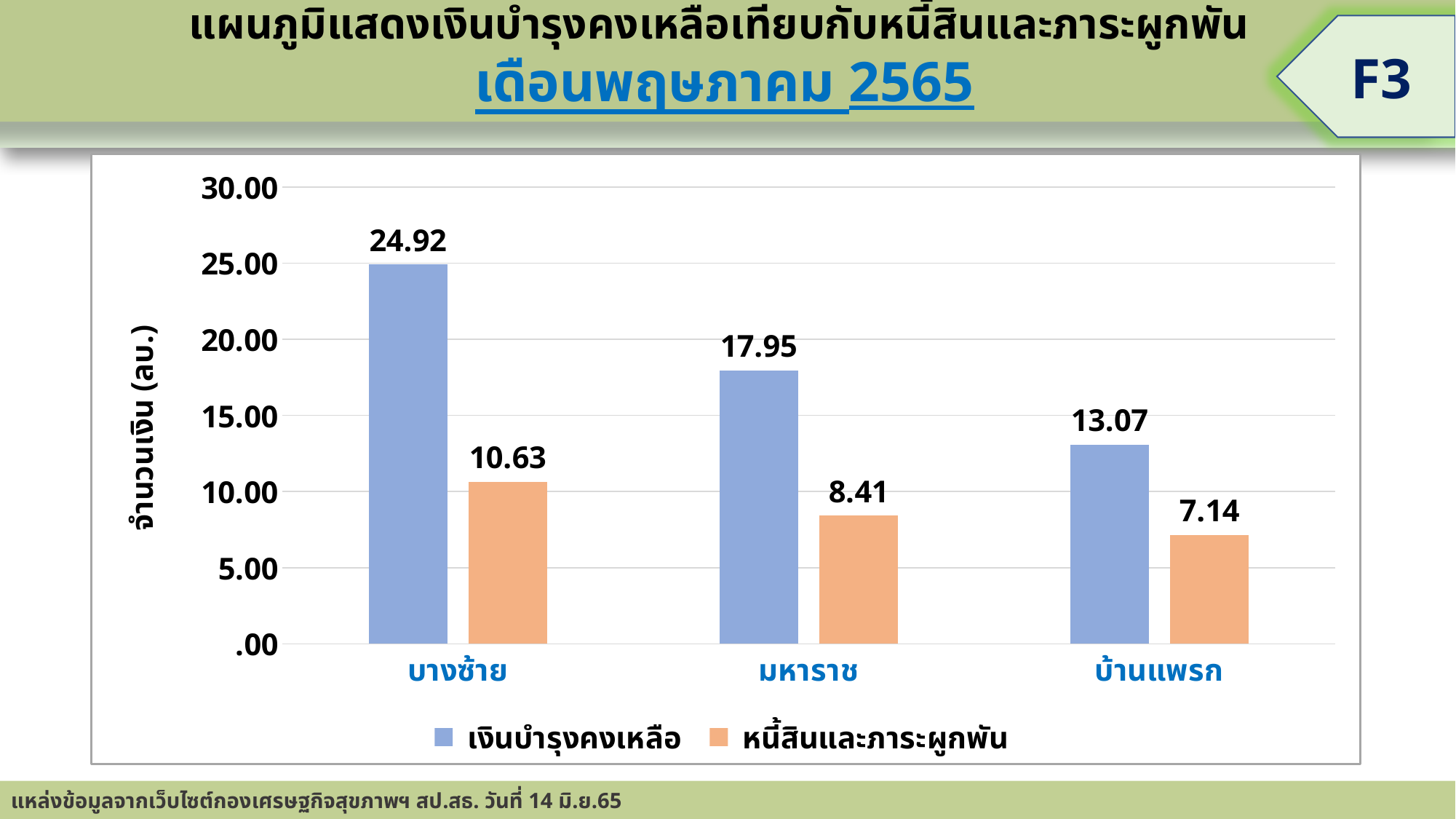
Do the values of เงินบำรุงคงเหลือ rise or fall from บางซ้าย to บ้านแพรก? fall What is the value of เงินบำรุงคงเหลือ for บางซ้าย? 24.92 What is the difference between เงินบำรุงคงเหลือ and หนี้สินและภาระผูกพัน for บางซ้าย? 14.29 Which category has the highest value of เงินบำรุงคงเหลือ? บางซ้าย What is the value of หนี้สินและภาระผูกพัน for มหาราช? 8.41 What is the value of เงินบำรุงคงเหลือ for บ้านแพรก? 13.07 How many series does the legend list? 2 What kind of chart is shown on the slide? bar chart Which category has the lowest value of หนี้สินและภาระผูกพัน? บ้านแพรก Is the value of เงินบำรุงคงเหลือ for มหาราช greater or less than 15.00? greater How many categories are shown on the x axis? 3 Which is larger: หนี้สินและภาระผูกพัน for บางซ้าย or เงินบำรุงคงเหลือ for บ้านแพรก? เงินบำรุงคงเหลือ for บ้านแพรก